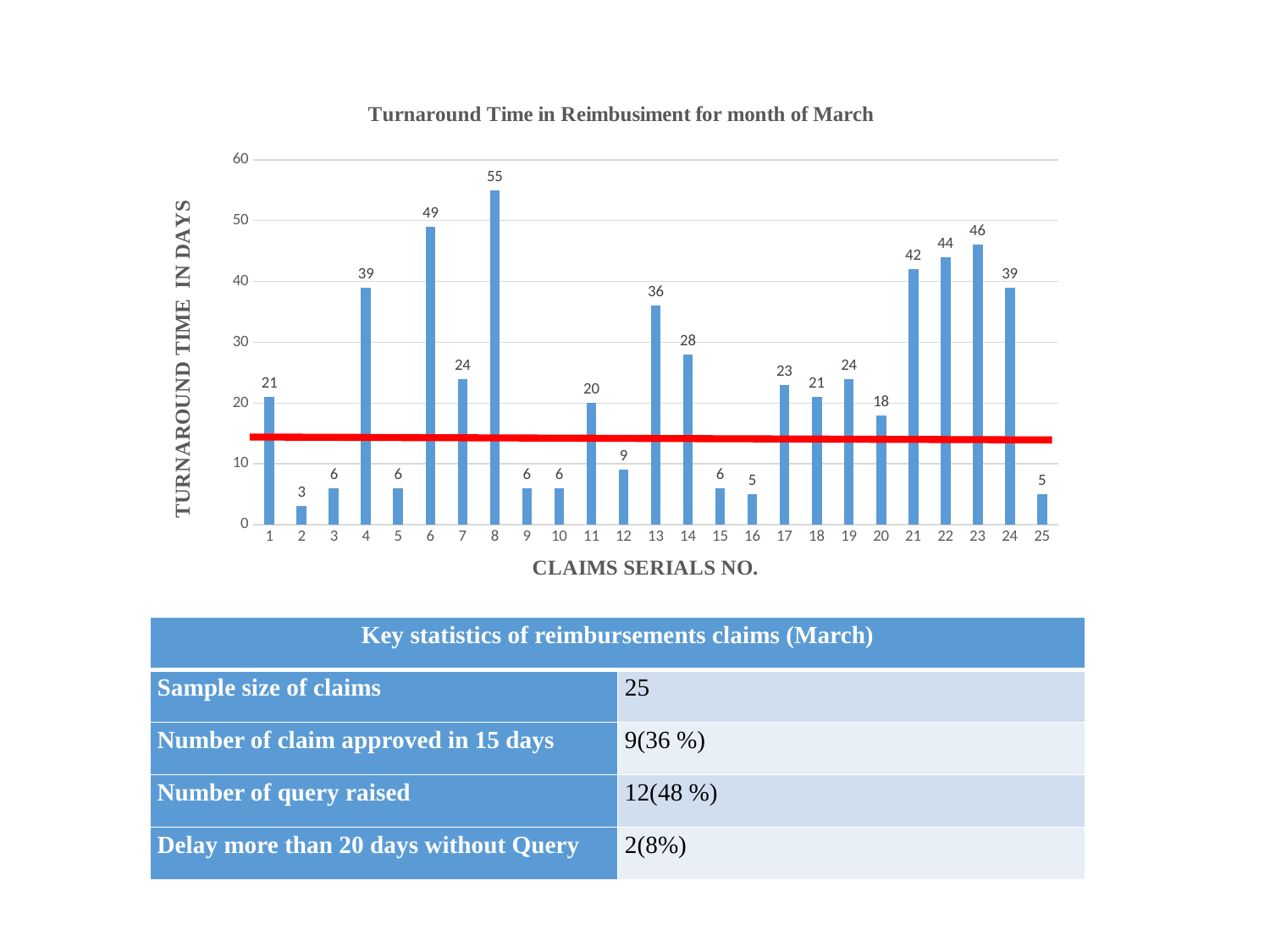
Which has a longer turnaround time, claim serial no. 14 or claim serial no. 17? Claim serial no. 14 What is the turnaround time in days for claim serial no. 13? 36 What is the difference in turnaround time between claim serial no. 6 and claim serial no. 4? 10 Which claim serial no. has the highest turnaround time? 8 What is the turnaround time in days for claim serial no. 8? 55 How many claim serial numbers are plotted on the x axis? 25 What type of chart is used to show the turnaround time? Bar chart What is the title of the chart? Turnaround Time in Reimbusiment for month of March Which claim serial no. has the lowest turnaround time? 2 Is the turnaround time for claim serial no. 22 greater or less than 40? greater What is the turnaround time in days for claim serial no. 20? 18 What is the difference in turnaround time between claim serial no. 23 and claim serial no. 21? 4